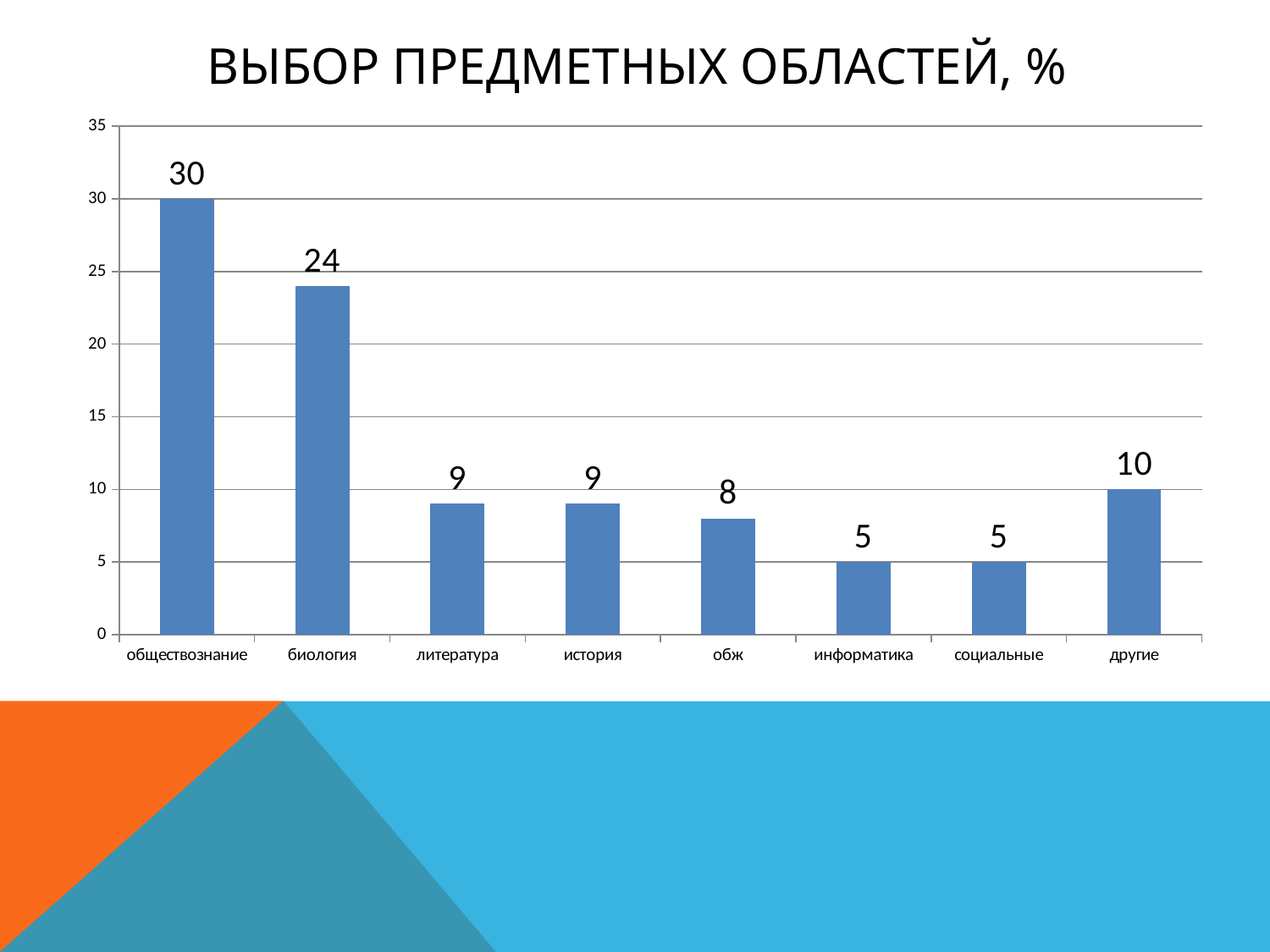
Is the value for биология greater or less than 20? greater What is the value for обществознание? 30 What is the difference between the values for обществознание and биология? 6 Which category has the highest value? обществознание How many categories are shown on the x axis? 8 What is the value for другие? 10 Which is larger, the value for литература or the value for обж? литература What kind of chart is shown on the slide? bar chart What is the value for обж? 8 What is the value for биология? 24 What is the title of the chart? ВЫБОР ПРЕДМЕТНЫХ ОБЛАСТЕЙ, % What is the difference between the values for другие and информатика? 5